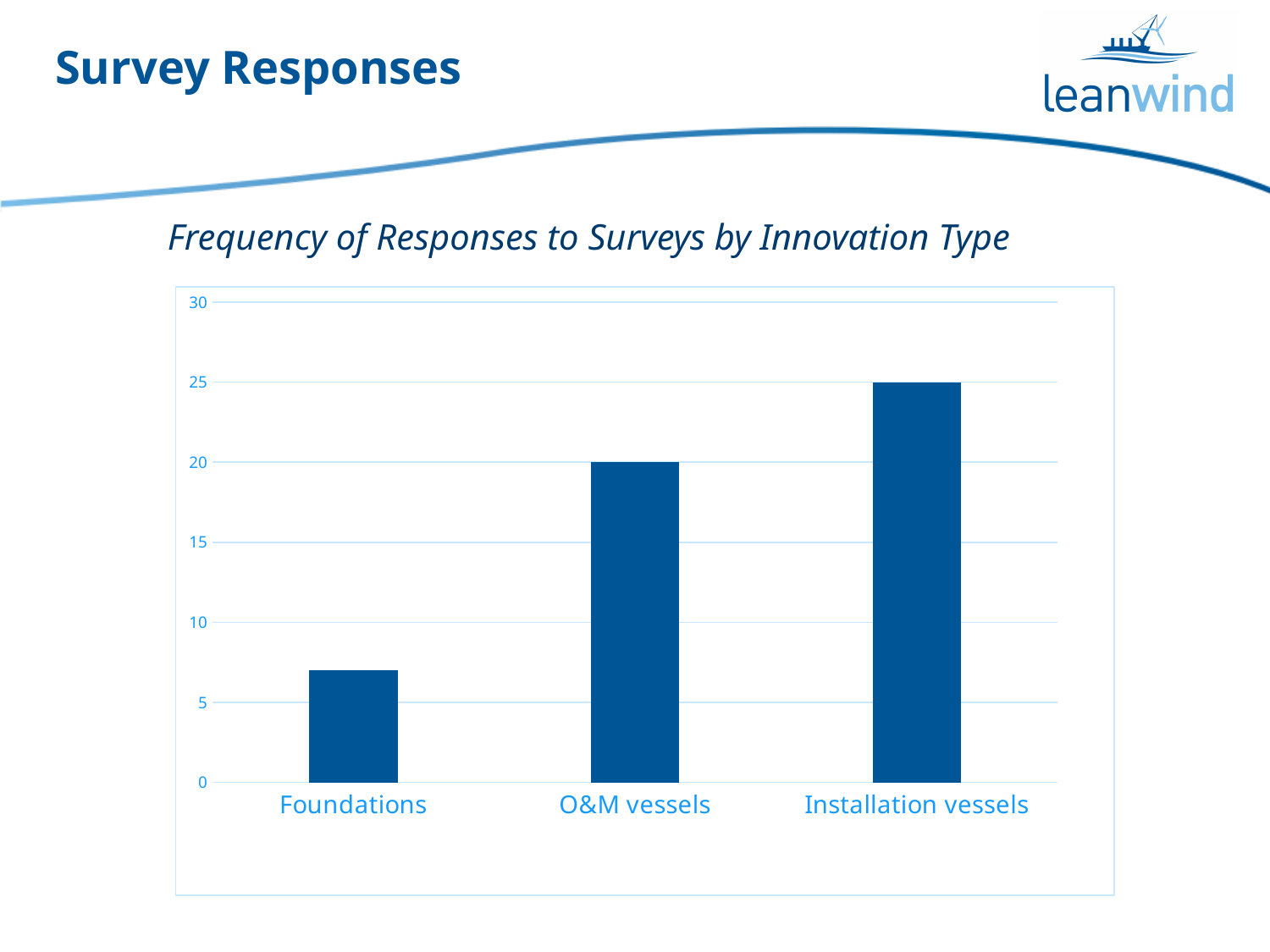
What type of chart is shown on the slide? bar chart Which category has the highest value? Installation vessels Is the value for Foundations greater or less than 5? greater What is the difference between the values for Installation vessels and O&M vessels? 5 What is the value for Installation vessels? 25 How many categories are shown on the x axis of the chart? 3 Which is larger, the value for Foundations or the value for O&M vessels? O&M vessels Which category has the lowest value? Foundations What is the value for O&M vessels? 20 Is the value for Foundations greater or less than 10? less Do the values rise or fall from left to right along the x axis? rise What is the title of the chart? Frequency of Responses to Surveys by Innovation Type